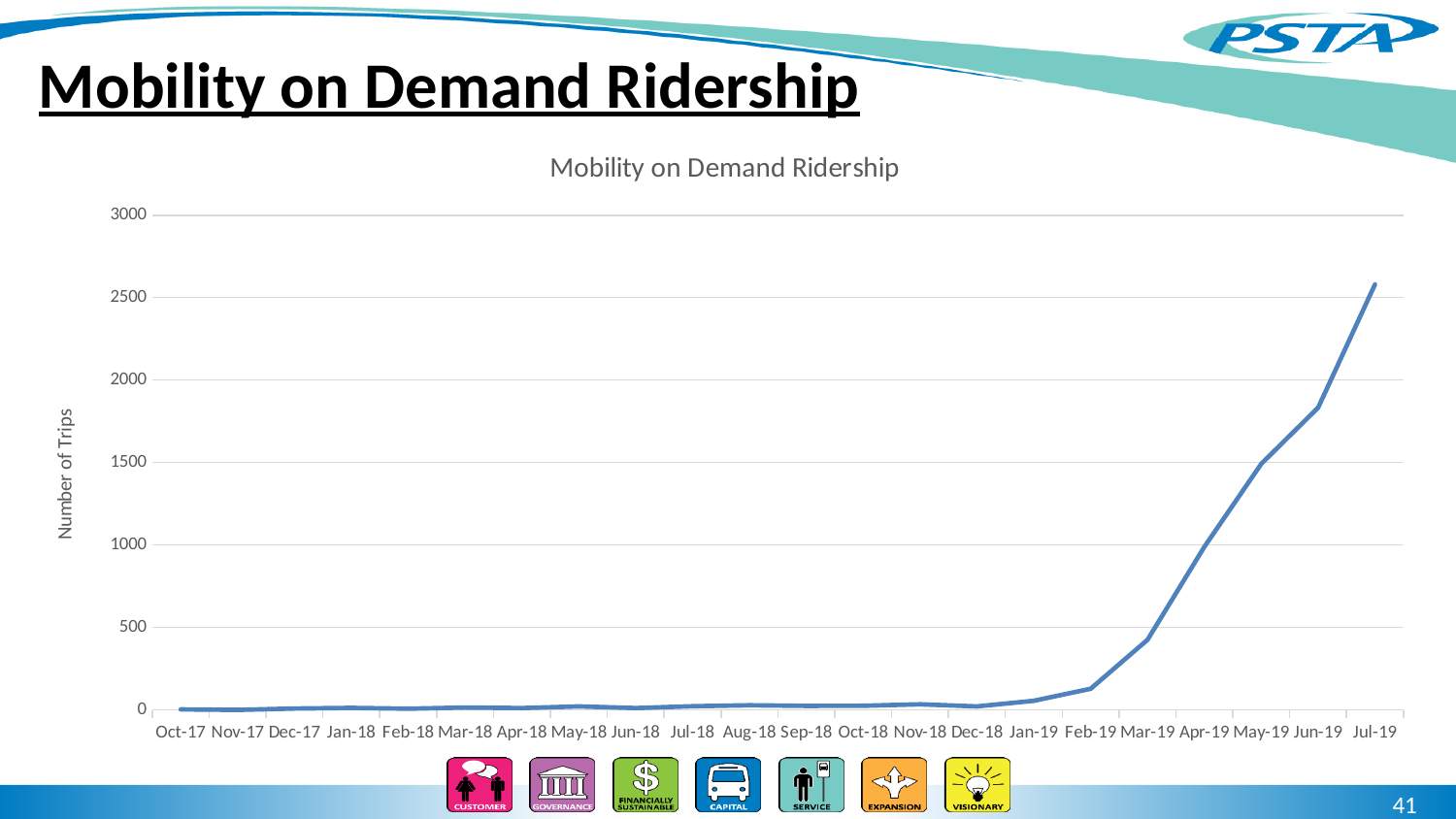
Is the value for Jun-19 greater or less than 2000? less What is the label on the vertical axis of the chart? Number of Trips Which month has the highest number of trips? Jul-19 Which is larger, the value for Jul-19 or the value for Jun-19? Jul-19 Do the values generally rise or fall from Oct-17 to Jul-19? rise Is the value for Jul-19 greater or less than 2000? greater What is the title of the chart? Mobility on Demand Ridership What kind of chart is shown on the slide? line chart Is the value for Mar-19 greater or less than 500? less How many months are plotted along the x axis of the chart? 22